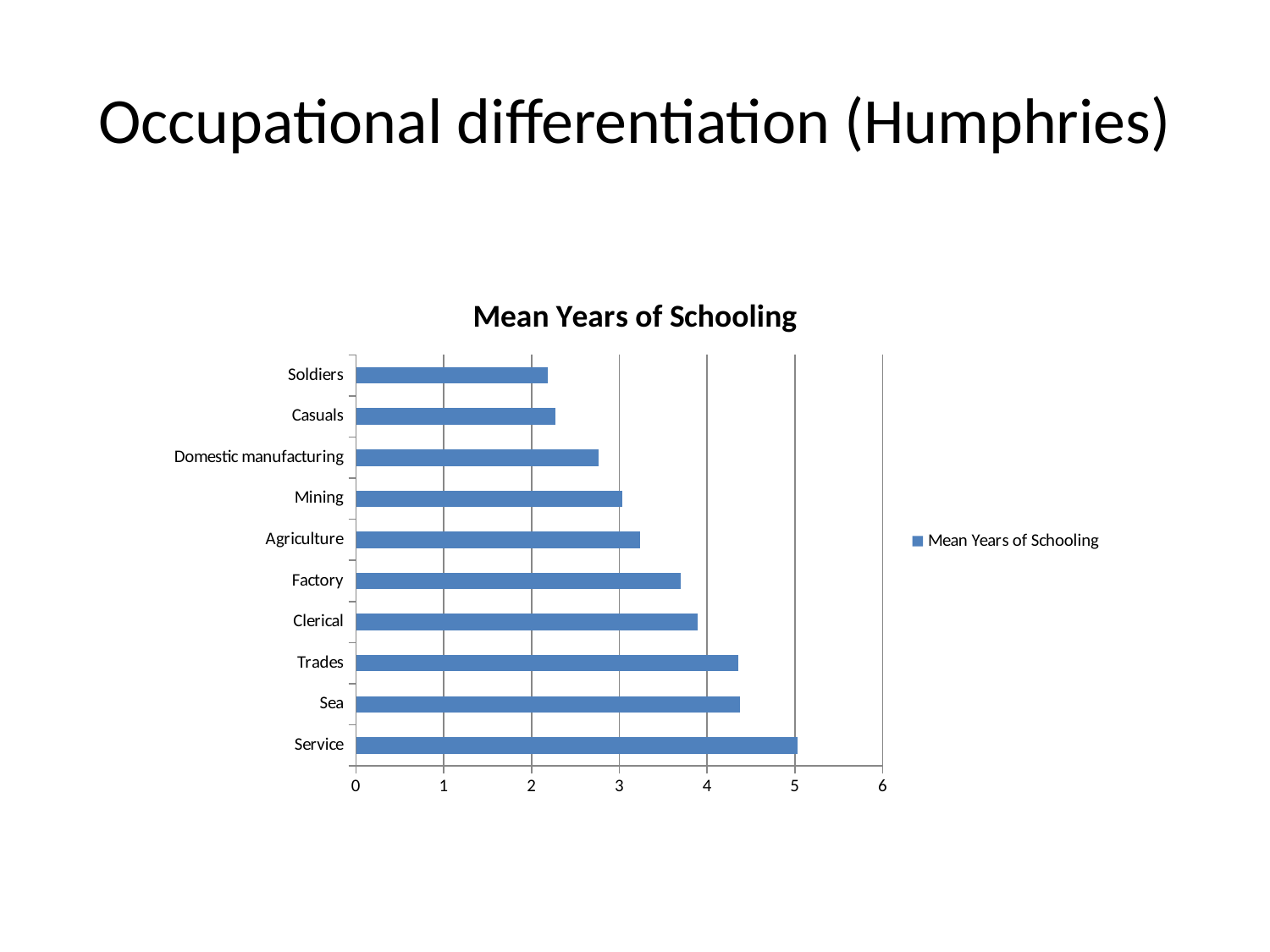
Is the value for Service greater or less than 4? greater What kind of chart is shown on the slide? Bar chart Which has a higher mean years of schooling, Factory or Mining? Factory Which occupation has the highest mean years of schooling? Service Is the value for Domestic manufacturing greater or less than 3? less Is the value for Trades greater or less than 4? greater What is the title of the chart? Mean Years of Schooling Which has a higher mean years of schooling, Casuals or Clerical? Clerical How many series does the legend list? 1 How many occupational categories are plotted in the chart? 10